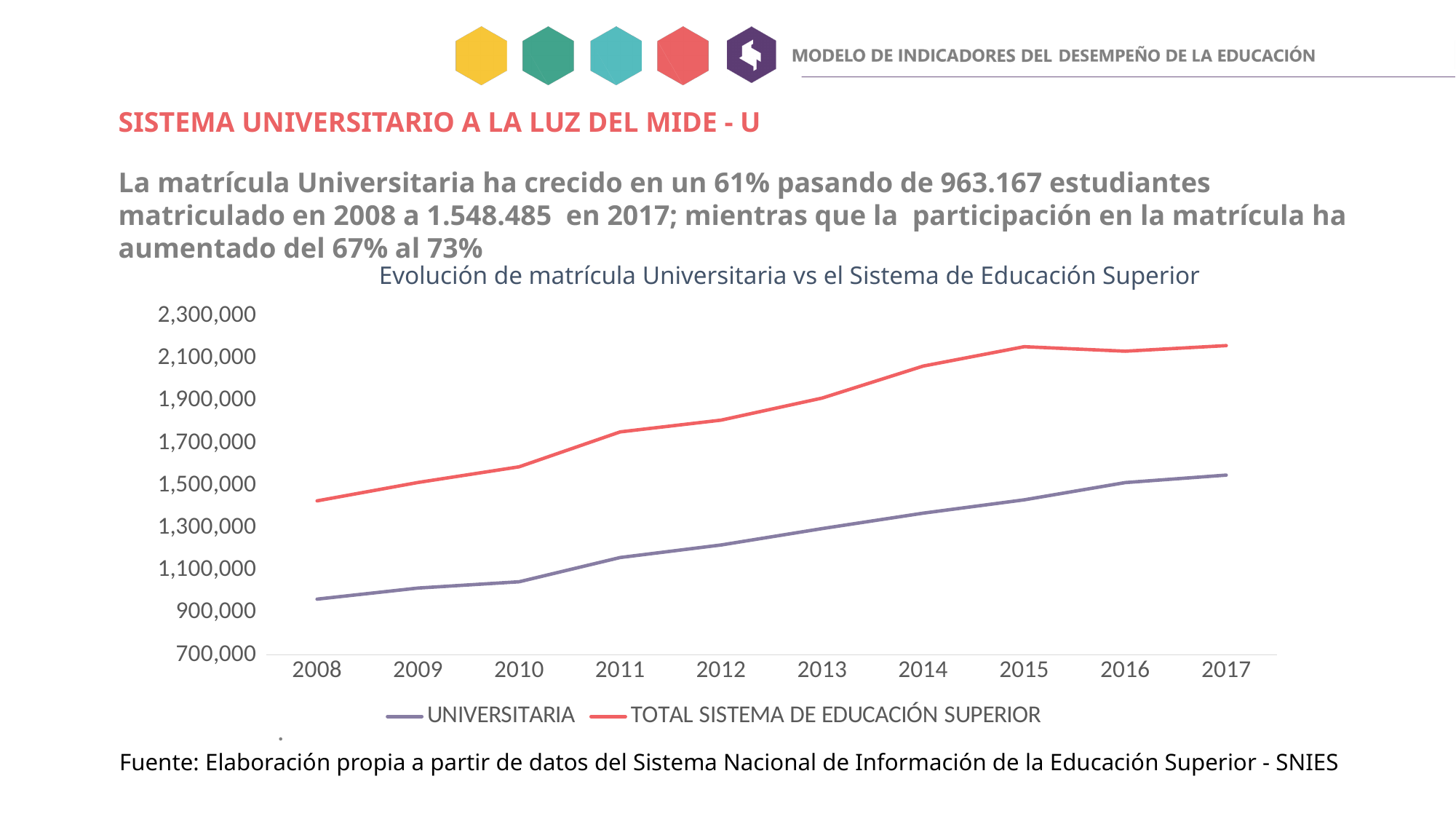
What kind of chart is shown on the slide? Line chart What is the title of the chart? Evolución de matrícula Universitaria vs el Sistema de Educación Superior In 2012, which series is higher: UNIVERSITARIA or TOTAL SISTEMA DE EDUCACIÓN SUPERIOR? TOTAL SISTEMA DE EDUCACIÓN SUPERIOR Is the value for TOTAL SISTEMA DE EDUCACIÓN SUPERIOR in 2017 greater or less than 2,100,000? greater How many series does the legend list? 2 Is the value for TOTAL SISTEMA DE EDUCACIÓN SUPERIOR in 2008 greater or less than 1,500,000? less Which series is drawn in red? TOTAL SISTEMA DE EDUCACIÓN SUPERIOR In which year is the UNIVERSITARIA series at its highest? 2017 Does the UNIVERSITARIA series rise or fall from 2008 to 2017? Rise In which year is the UNIVERSITARIA series at its lowest? 2008 How many years are plotted along the x axis? 10 Is the value for UNIVERSITARIA in 2008 greater or less than 1,100,000? less